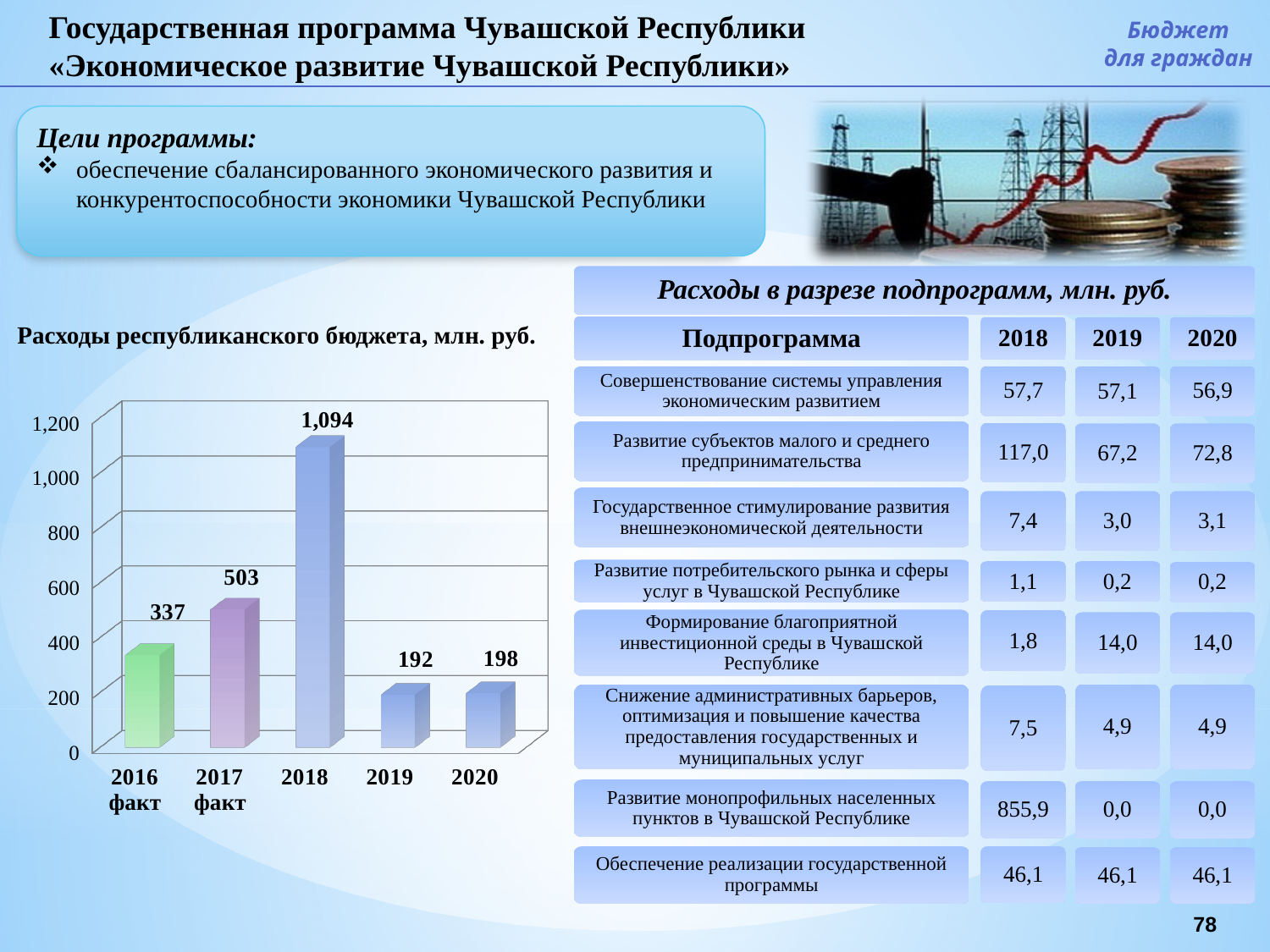
What kind of chart is used to show 'Расходы республиканского бюджета, млн. руб.'? bar chart What is the difference between the values for 2018 and 2017 факт in the bar chart? 591 What is the value for 2016 факт in the bar chart? 337 What is the title of the chart on the left side of the slide? Расходы республиканского бюджета, млн. руб. Is the value for 2018 in the bar chart greater or less than 1,000? greater Which year has the highest value in the bar chart? 2018 Which year has the lowest value in the bar chart? 2019 Which is larger in the bar chart, the value for 2017 факт or the value for 2016 факт? 2017 факт What is the difference between the values for 2017 факт and 2016 факт in the bar chart? 166 What is the value for 2018 in the chart 'Расходы республиканского бюджета, млн. руб.'? 1,094 How many years (categories) are shown in the bar chart? 5 What is the value for 2020 in the bar chart? 198